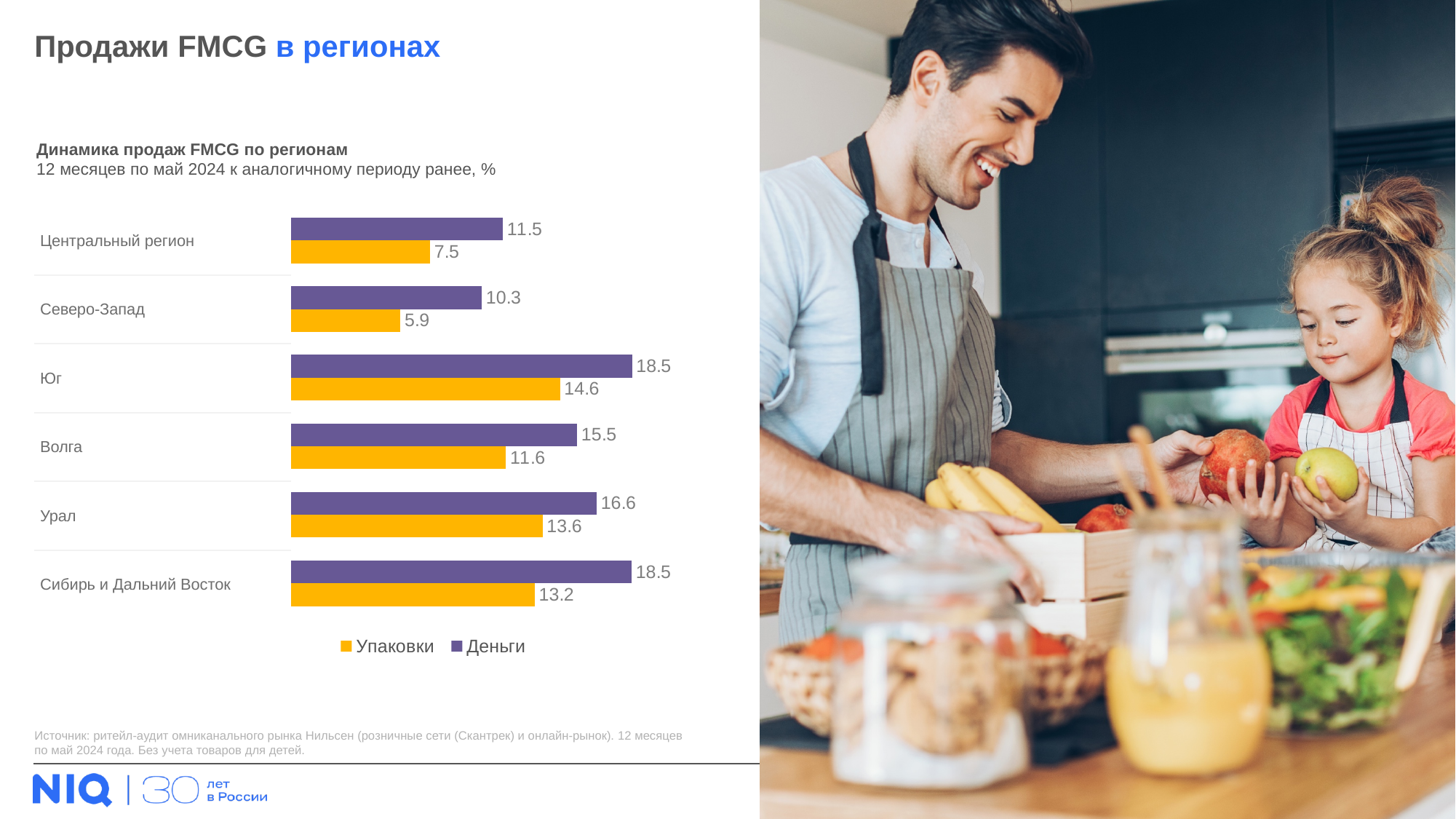
Which region has the highest Упаковки value? Юг What is the difference between the Упаковки values for Урал and Волга? 2.0 What type of chart is shown on the slide? Bar chart What is the Деньги value for Волга? 15.5 How many series does the legend list? 2 What is the Упаковки value for Северо-Запад? 5.9 What is the Упаковки value for Сибирь и Дальний Восток? 13.2 Which region has the lowest Деньги value? Северо-Запад What is the difference between the Деньги and Упаковки values for Центральный регион? 4.0 How many regions are shown in the chart? 6 Which colour represents the Упаковки series? Yellow Which is larger: the Деньги value for Урал or the Деньги value for Волга? Урал